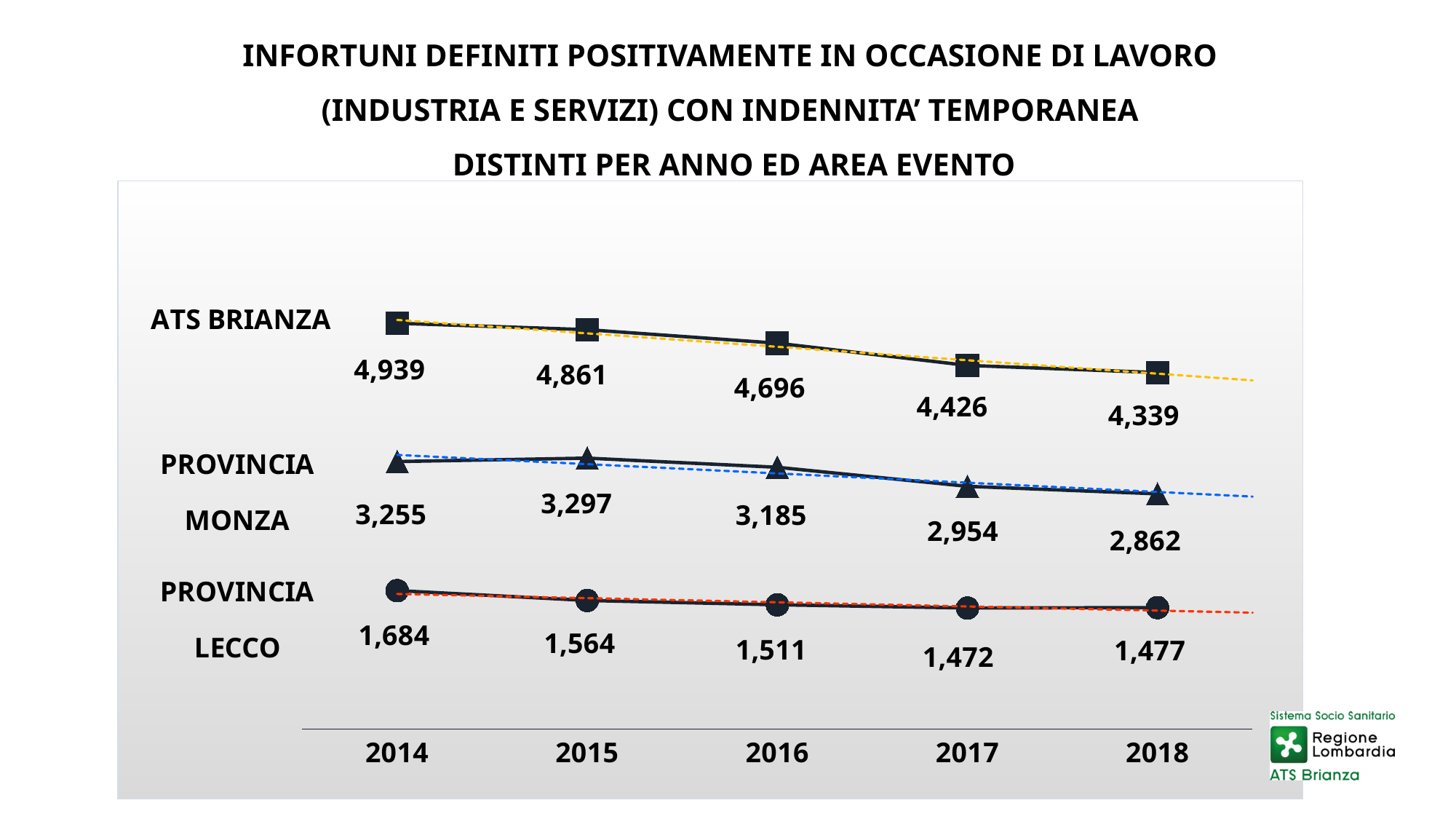
How many years are shown on the x axis? 5 In which year is the value for PROVINCIA LECCO lowest? 2017 Do the ATS BRIANZA values rise or fall from 2014 to 2018? Fall How many series are plotted on the chart? 3 What is the value for PROVINCIA MONZA in 2016? 3,185 In which year is the value for PROVINCIA MONZA highest? 2015 What is the value for ATS BRIANZA in 2014? 4,939 What is the difference between the ATS BRIANZA values for 2014 and 2018? 600 Which is larger, the PROVINCIA MONZA value in 2017 or the PROVINCIA LECCO value in 2014? PROVINCIA MONZA in 2017 What is the value for PROVINCIA LECCO in 2018? 1,477 What marker shape is used for the PROVINCIA MONZA series? Triangle What kind of chart is shown on the slide? Line chart